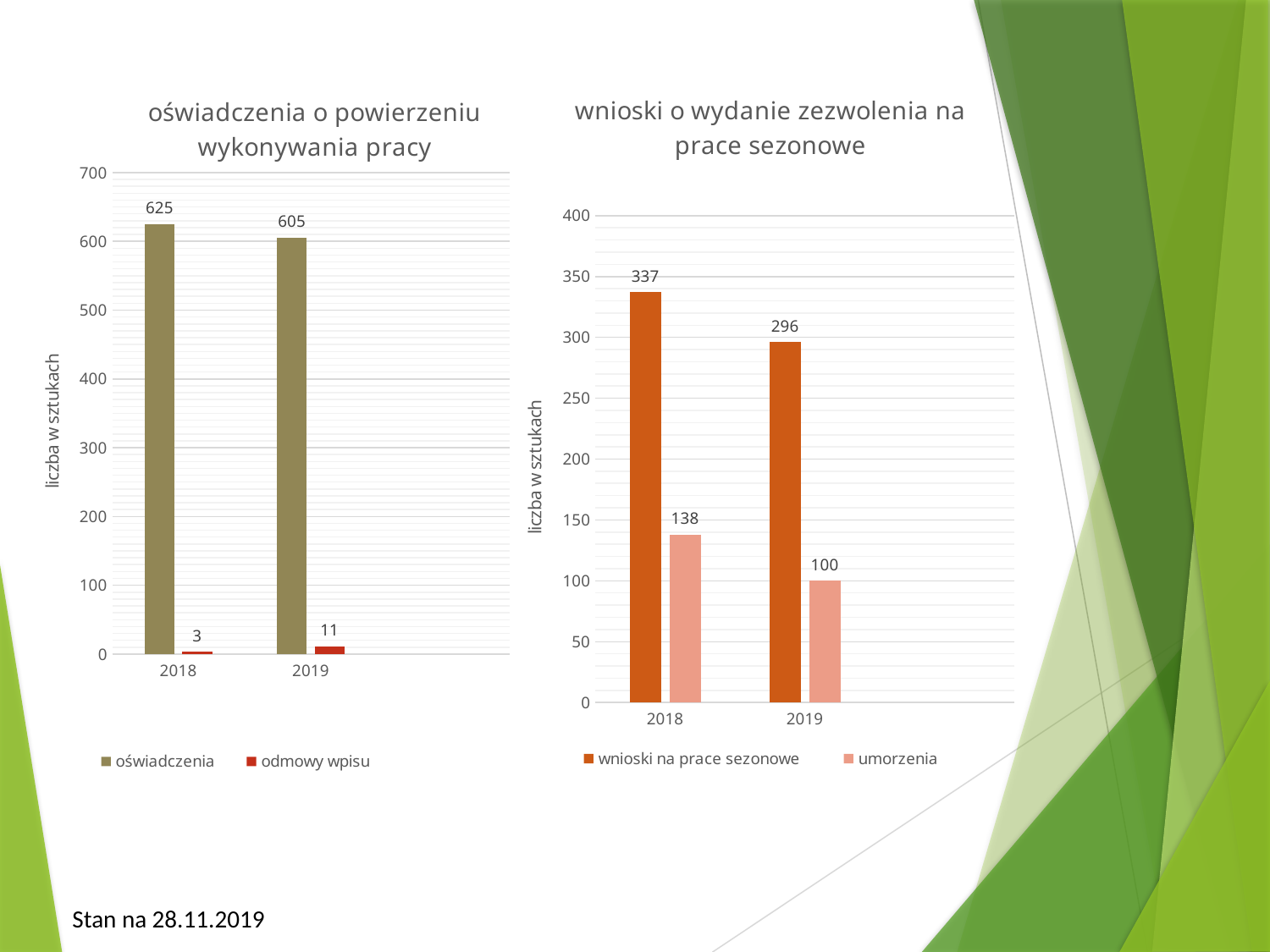
In the left chart 'oświadczenia o powierzeniu wykonywania pracy', what is the value of 'oświadczenia' for 2018? 625 In the right chart 'wnioski o wydanie zezwolenia na prace sezonowe', which year has the lower 'umorzenia' value? 2019 In the right chart 'wnioski o wydanie zezwolenia na prace sezonowe', does the 'wnioski na prace sezonowe' value rise or fall from 2018 to 2019? fall In the left chart 'oświadczenia o powierzeniu wykonywania pracy', which year has the higher 'odmowy wpisu' value? 2019 In the left chart 'oświadczenia o powierzeniu wykonywania pracy', how many series does the legend list? 2 In the right chart 'wnioski o wydanie zezwolenia na prace sezonowe', what is the value of 'wnioski na prace sezonowe' for 2019? 296 In the right chart 'wnioski o wydanie zezwolenia na prace sezonowe', what is the value of 'umorzenia' for 2018? 138 In the left chart 'oświadczenia o powierzeniu wykonywania pracy', what is the difference between the 'oświadczenia' values for 2018 and 2019? 20 What kind of chart is the right chart 'wnioski o wydanie zezwolenia na prace sezonowe'? bar chart In the right chart 'wnioski o wydanie zezwolenia na prace sezonowe', what is the difference between 'wnioski na prace sezonowe' and 'umorzenia' in 2018? 199 What is the y-axis label of the left chart 'oświadczenia o powierzeniu wykonywania pracy'? liczba w sztukach In the left chart 'oświadczenia o powierzeniu wykonywania pracy', what is the value of 'odmowy wpisu' for 2019? 11